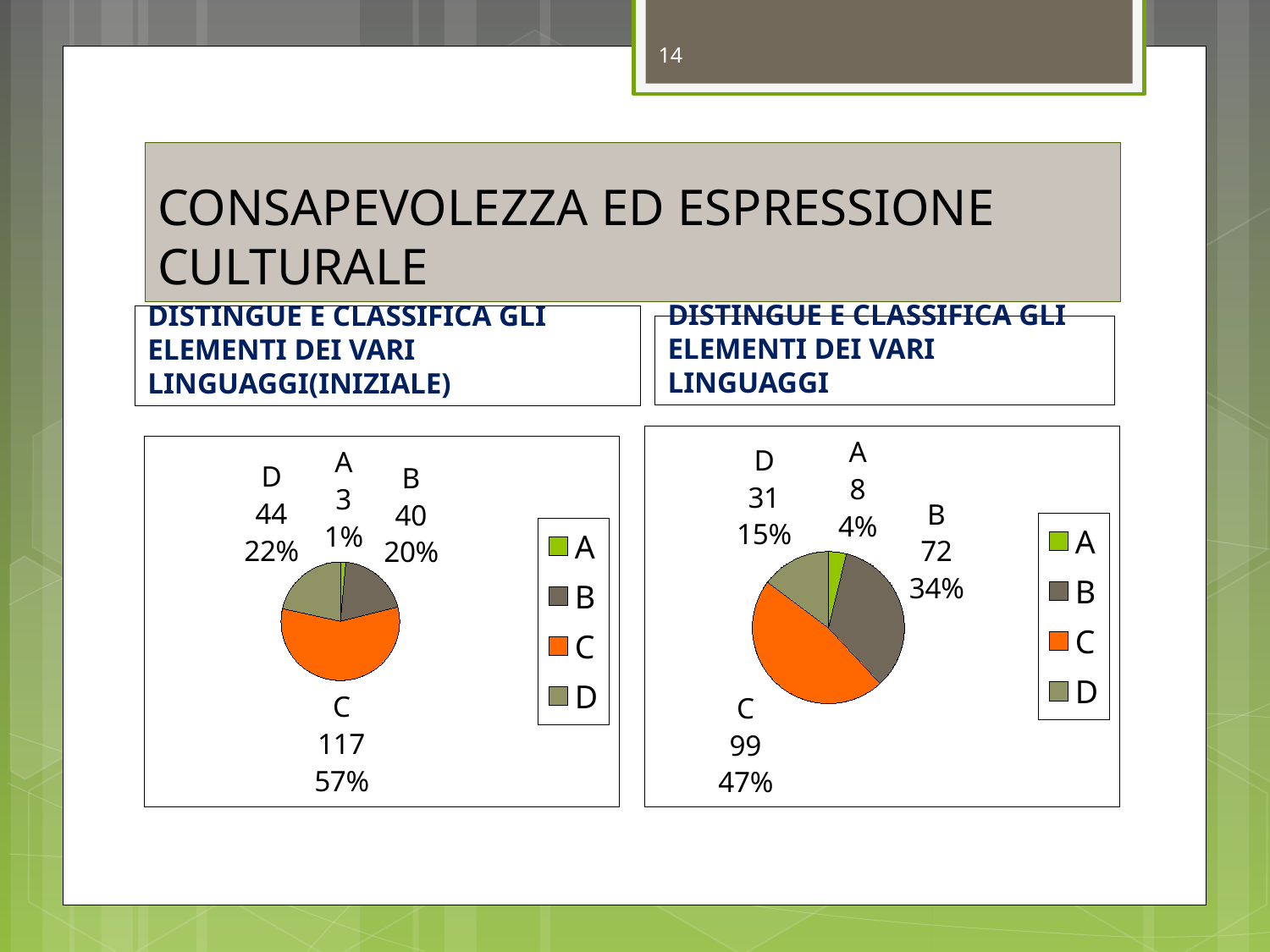
What type of chart is shown on the left side of the slide? Pie chart In the right pie chart, what is the difference between the values for C and B? 27 In the right pie chart, what percentage share does category A have? 4% In the left pie chart (INIZIALE), which category has the largest slice? C In the right pie chart, what colour is the slice for category C? Orange How many entries does the legend of the left chart list? 4 In the right pie chart, which category has the smallest slice? A How many categories does the right pie chart show? 4 In the left pie chart (INIZIALE), what percentage share does category D have? 22% In the left pie chart (INIZIALE), which is larger, the value for B or the value for D? D In the left pie chart (INIZIALE), what is the value for category C? 117 In the right pie chart, what is the value for category B? 72